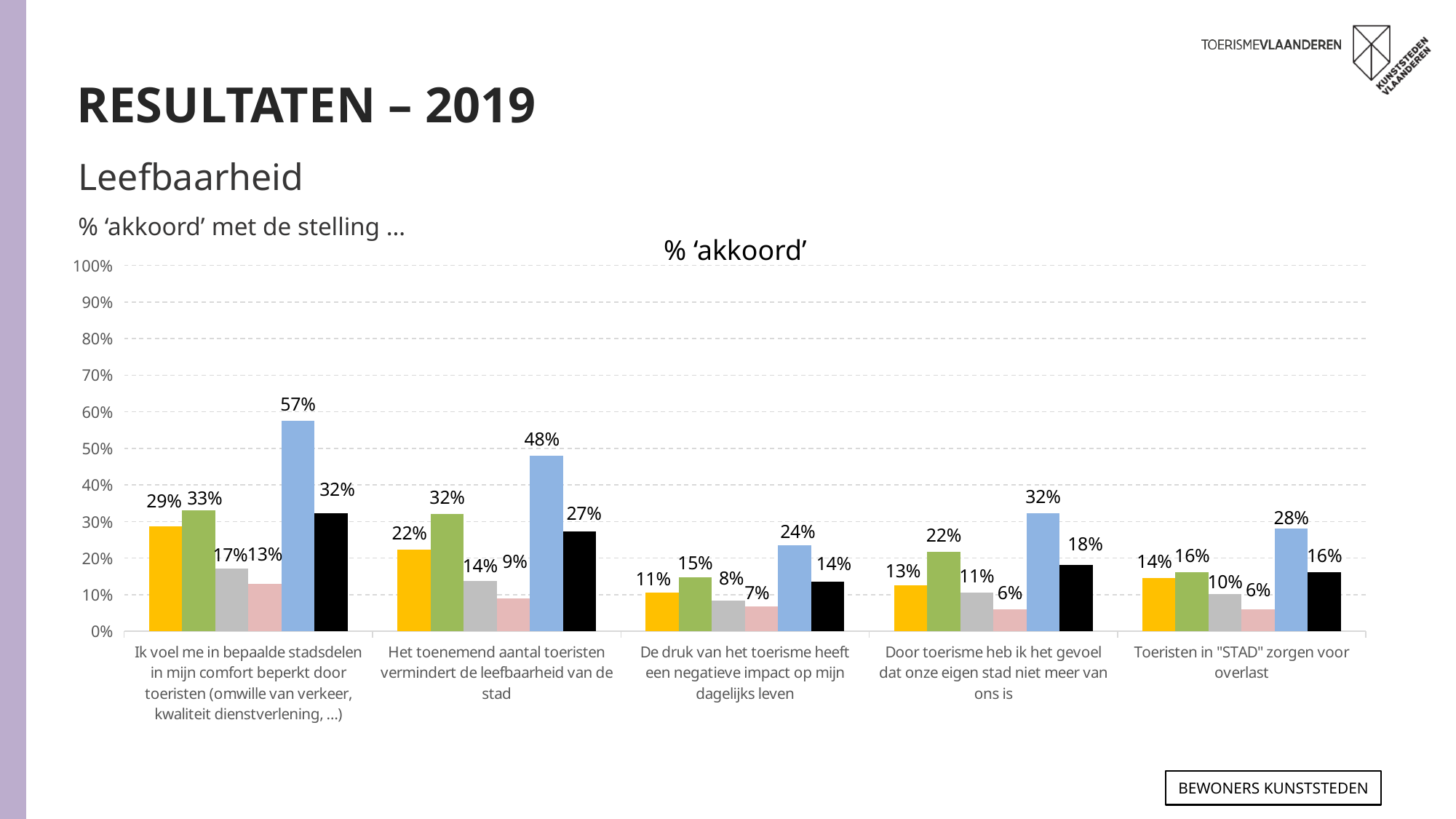
What is the value of the pink bar for the statement 'De druk van het toerisme heeft een negatieve impact op mijn dagelijks leven'? 7% What is the title of the chart? % ‘akkoord’ What is the difference between the blue bar and the black bar for the statement 'Door toerisme heb ik het gevoel dat onze eigen stad niet meer van ons is'? 14% Which statement has the lowest yellow bar in the chart? De druk van het toerisme heeft een negatieve impact op mijn dagelijks leven Which statement has the highest blue bar in the chart? Ik voel me in bepaalde stadsdelen in mijn comfort beperkt door toeristen Is the value of the blue bar for 'Het toenemend aantal toeristen vermindert de leefbaarheid van de stad' greater or less than 50%? less For the statement 'Toeristen in "STAD" zorgen voor overlast', which is larger: the blue bar or the green bar? the blue bar What is the value of the blue bar for the statement 'Ik voel me in bepaalde stadsdelen in mijn comfort beperkt door toeristen'? 57% What is the value of the green bar for the statement 'Het toenemend aantal toeristen vermindert de leefbaarheid van de stad'? 32% How many bars are plotted for each statement in the chart? 6 What type of chart is shown on the slide? bar chart How many statements (categories) are shown along the x axis of the chart? 5